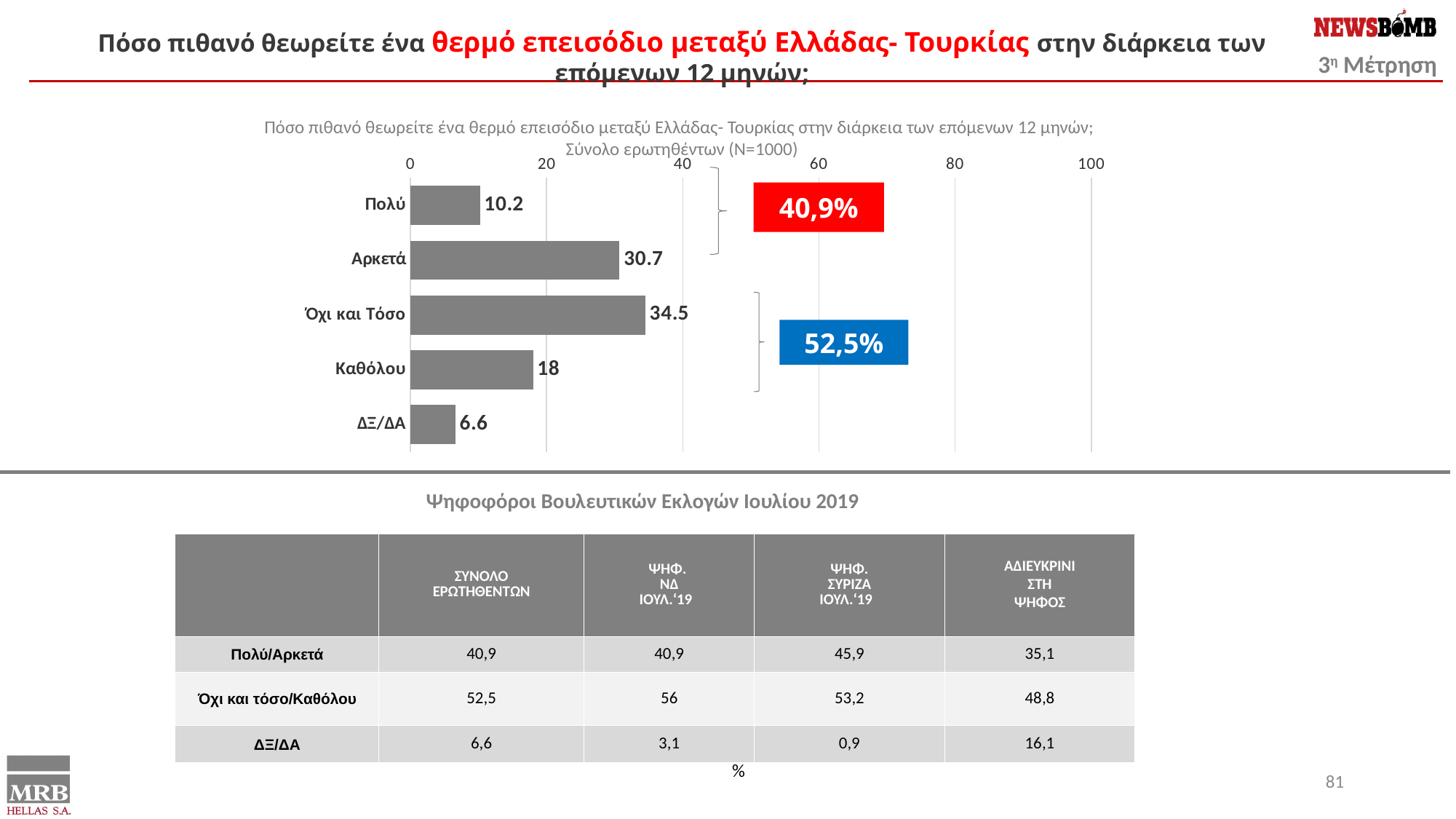
What is the value for ΔΞ/ΔΑ? 6.6 Which is larger, the value for Καθόλου or the value for Πολύ? Καθόλου What is the value for Αρκετά? 30.7 What kind of chart is shown on the slide? bar chart Which category has the highest value? Όχι και Τόσο How many categories are shown in the bar chart? 5 Which category has the lowest value? ΔΞ/ΔΑ What is the difference between the values for Όχι και Τόσο and Αρκετά? 3.8 Is the value for Αρκετά greater or less than 20? greater What percentage is shown in the red box next to the chart? 40,9% What is the value for Καθόλου? 18 What is the value for Πολύ? 10.2